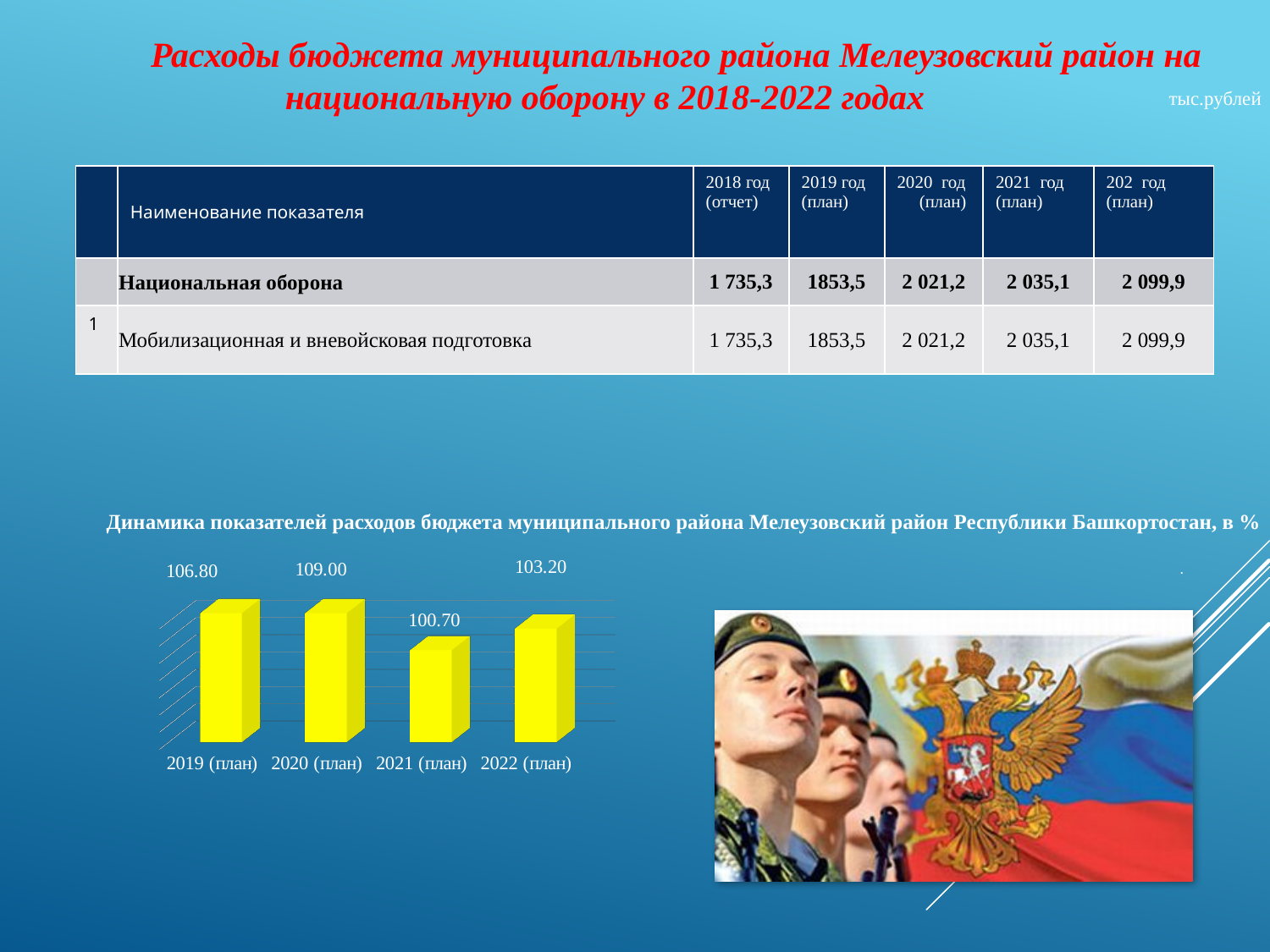
Which is larger, the value for 2019 (план) or the value for 2022 (план)? 2019 (план) What is the value for 2019 (план) in the chart? 106.80 What is the difference between the values for 2019 (план) and 2022 (план)? 3.60 Which category has the highest value in the chart? 2020 (план) What colour are the bars in the chart? Yellow What is the value for 2022 (план) in the chart? 103.20 How many categories are shown in the chart? 4 What is the difference between the values for 2020 (план) and 2021 (план)? 8.30 What is the value for 2021 (план) in the chart? 100.70 What kind of chart is shown on the slide? Bar chart What is the value for 2020 (план) in the chart? 109.00 Which category has the lowest value in the chart? 2021 (план)